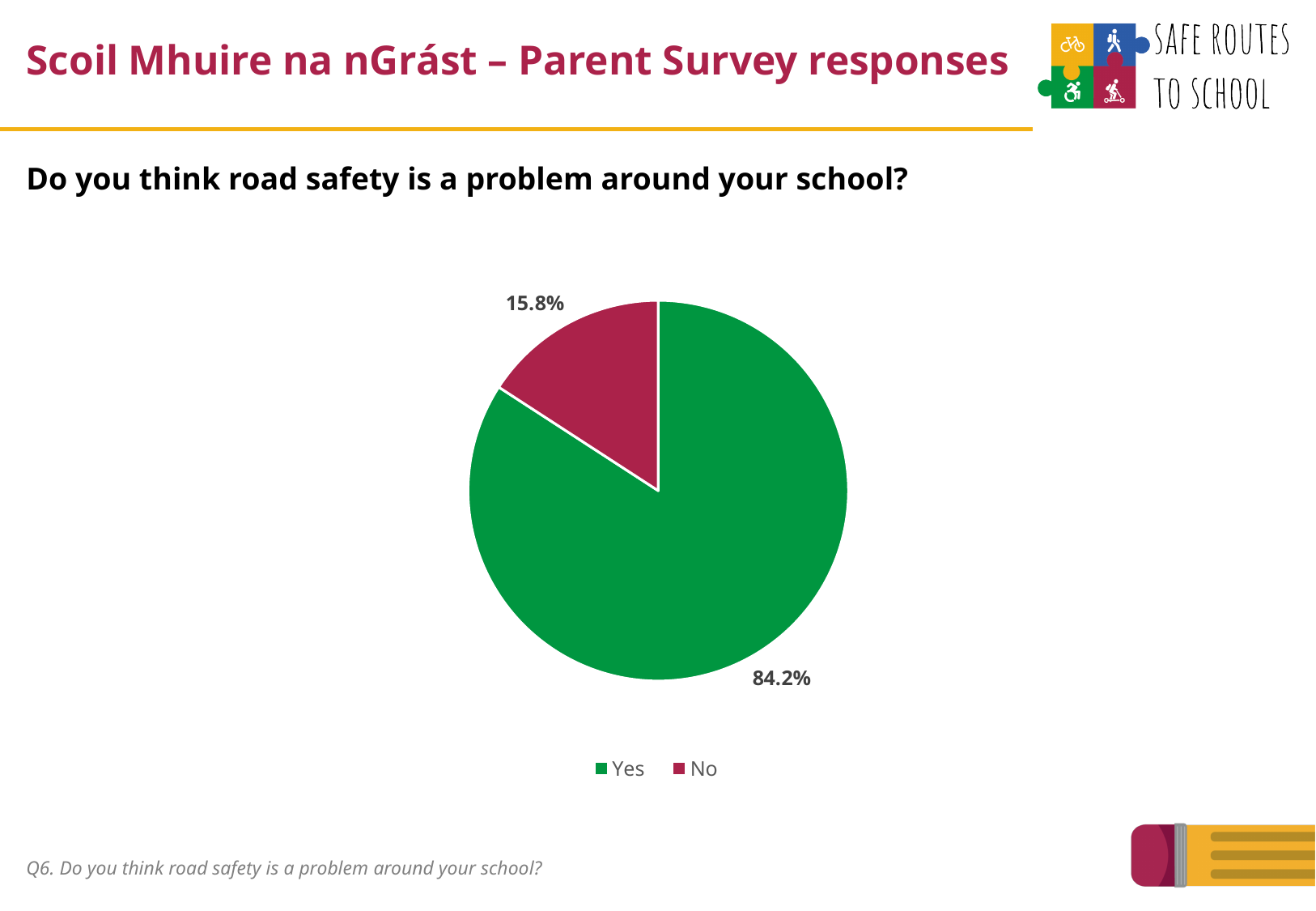
What percentage of parents answered No to whether road safety is a problem around the school? 15.8% What is the difference in percentage points between the Yes and No responses? 68.4 Which response is larger, Yes or No? Yes Which response received the smallest share of the pie? No What percentage of parents answered Yes to whether road safety is a problem around the school? 84.2% What survey question does the chart on the slide show responses to? Do you think road safety is a problem around your school? What share of the pie does the No slice represent? 15.8% How many entries does the legend list? 2 How many slices does the pie chart have? 2 What colour is the Yes slice of the pie chart? Green What kind of chart is shown on the slide? Pie chart Which response received the largest share of the pie? Yes